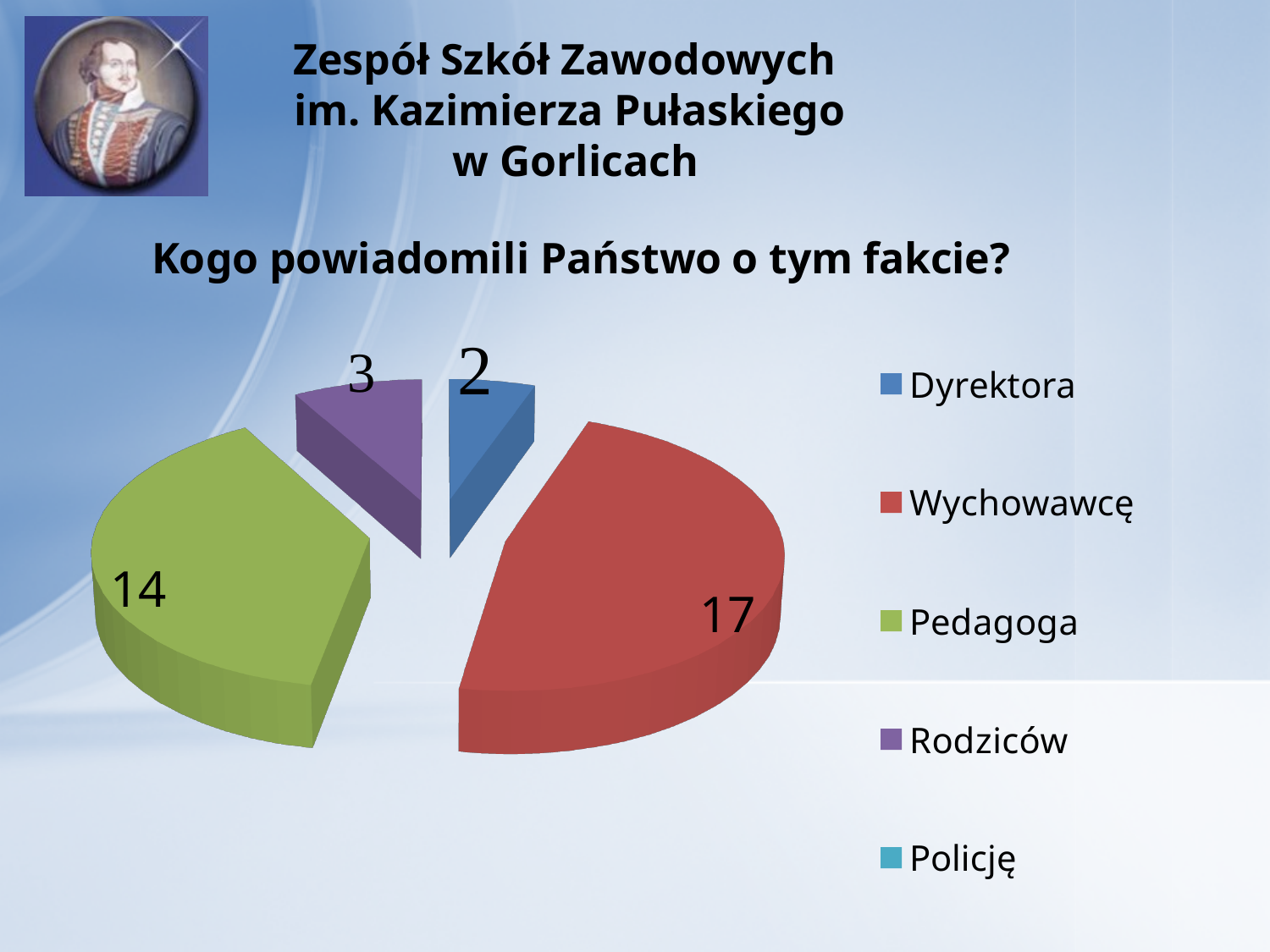
What value is shown for the Dyrektora slice of the pie chart? 2 Which category has the largest slice in the pie chart? Wychowawcę What is the difference between the values for Pedagoga and Rodziców? 11 Which is larger, the value for Dyrektora or the value for Rodziców? Rodziców How many entries does the chart legend list? 5 What value is shown for the Wychowawcę slice of the pie chart? 17 What value is shown for the Rodziców slice of the pie chart? 3 What is the difference between the values for Wychowawcę and Pedagoga? 3 What kind of chart is shown on the slide? Pie chart Which is larger, the value for Wychowawcę or the value for Pedagoga? Wychowawcę What value is shown for the Pedagoga slice of the pie chart? 14 What colour is the Pedagoga slice in the pie chart? Green